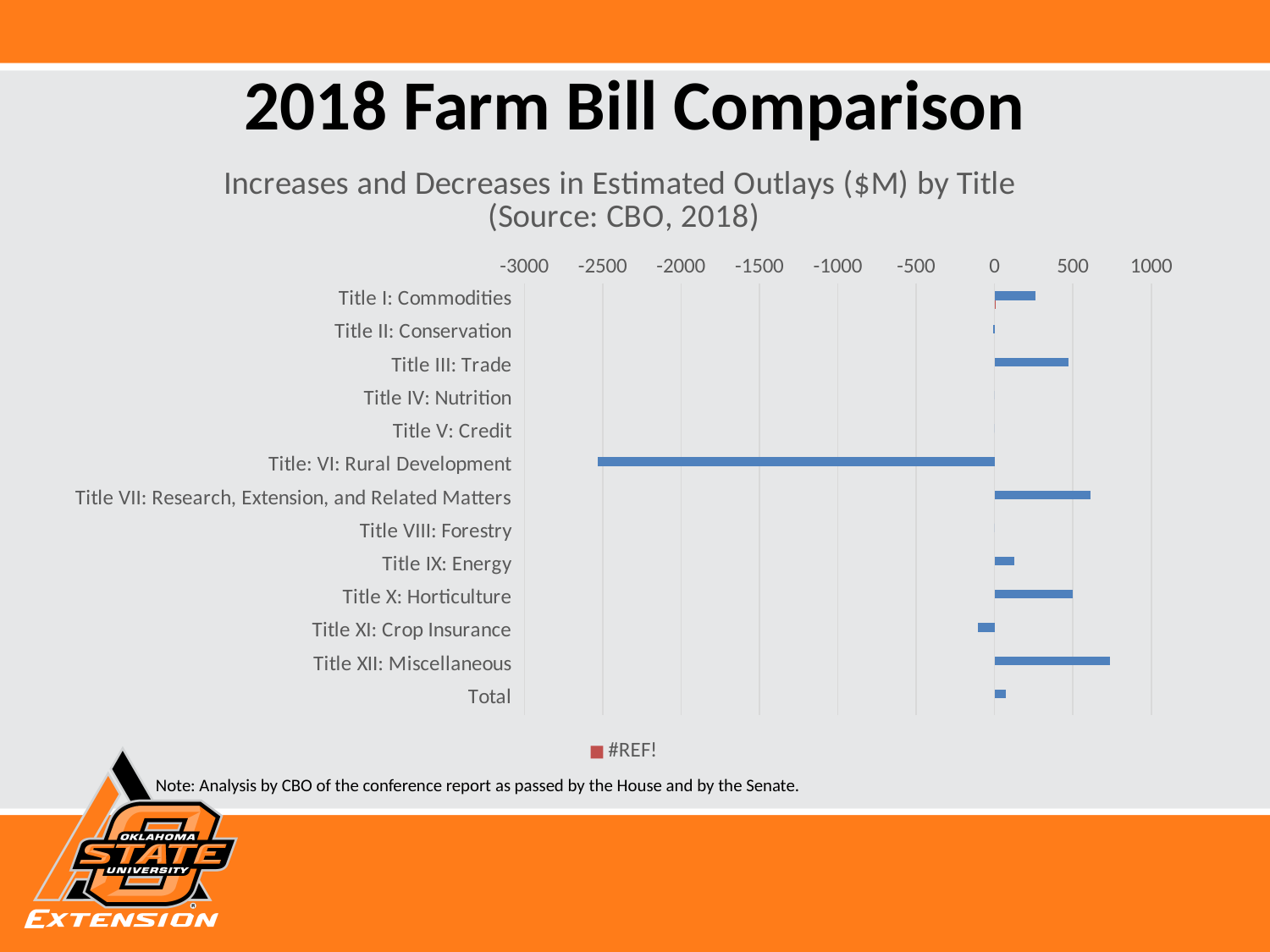
How many series does the legend list? 1 What kind of chart is shown on the slide? bar chart Which is larger, the value for Title VII: Research, Extension, and Related Matters or the value for Title I: Commodities? Title VII: Research, Extension, and Related Matters Is the value for Title XII: Miscellaneous greater or less than 500? greater Is the value for Title XI: Crop Insurance greater or less than 0? less How many categories are plotted on the chart? 13 Is the value for Title I: Commodities greater or less than 500? less Which category has the lowest value on the chart? Title: VI: Rural Development Which category has the highest value on the chart? Title XII: Miscellaneous Which is larger, the value for Title XI: Crop Insurance or the value for Title: VI: Rural Development? Title XI: Crop Insurance What text appears as the legend entry below the chart? #REF!